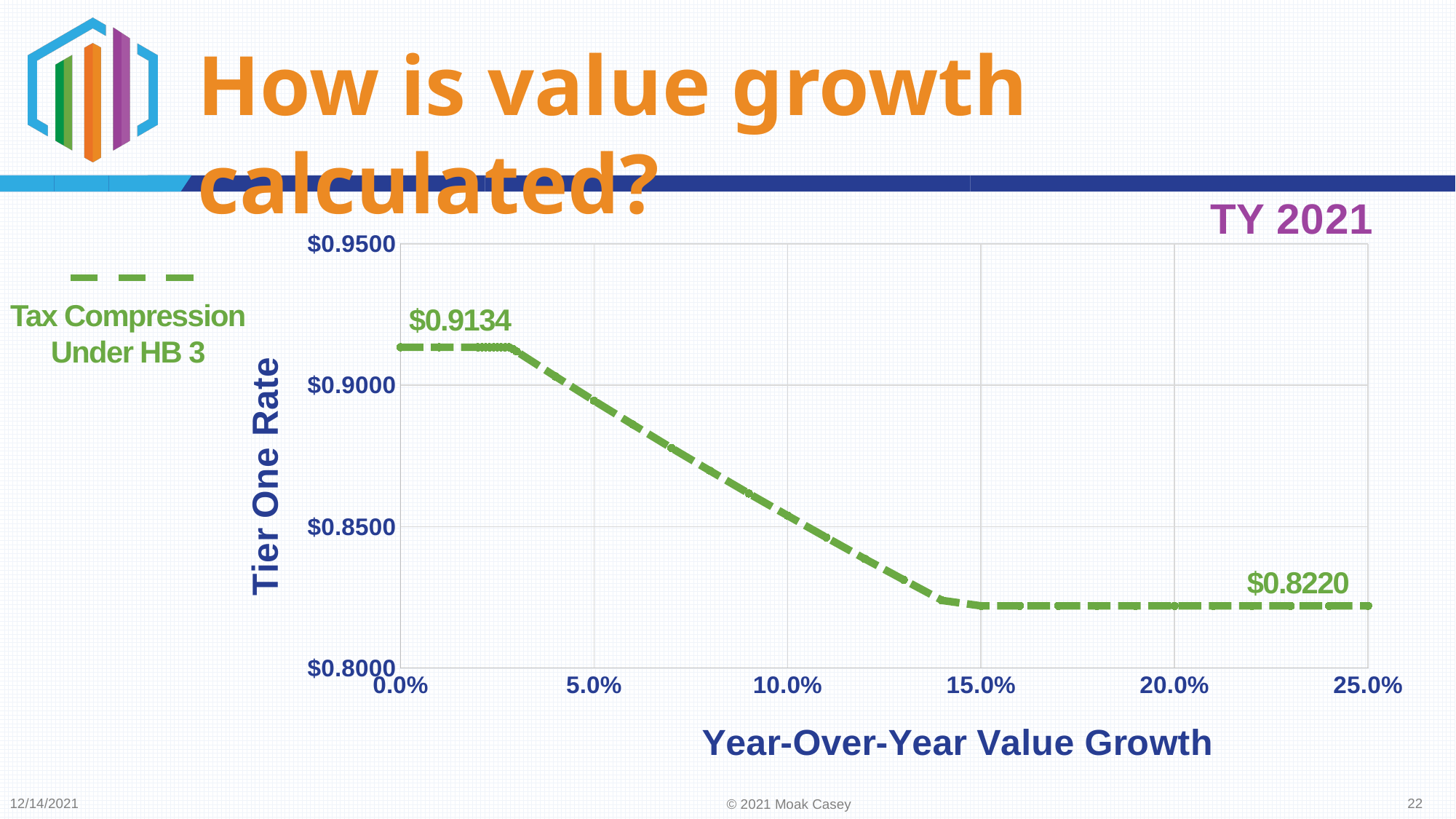
What is the difference between the Tier One Rate at 0.0% growth and at 25.0% growth? $0.0914 Is the Tier One Rate at 10.0% value growth greater or less than $0.8500? greater What is the highest Tier One Rate labeled on the chart? $0.9134 Is the Tier One Rate at 20.0% value growth greater or less than $0.8500? less What is the Tier One Rate at 25.0% year-over-year value growth? $0.8220 What kind of chart is shown on the slide? line chart What is the lowest Tier One Rate labeled on the chart? $0.8220 How many series does the legend list? 1 Which is larger, the Tier One Rate at 0.0% growth or at 25.0% growth? 0.0% growth What is the Tier One Rate at 0.0% year-over-year value growth? $0.9134 Does the Tier One Rate rise or fall as year-over-year value growth increases from 5.0% to 15.0%? fall What is the title of the x axis? Year-Over-Year Value Growth